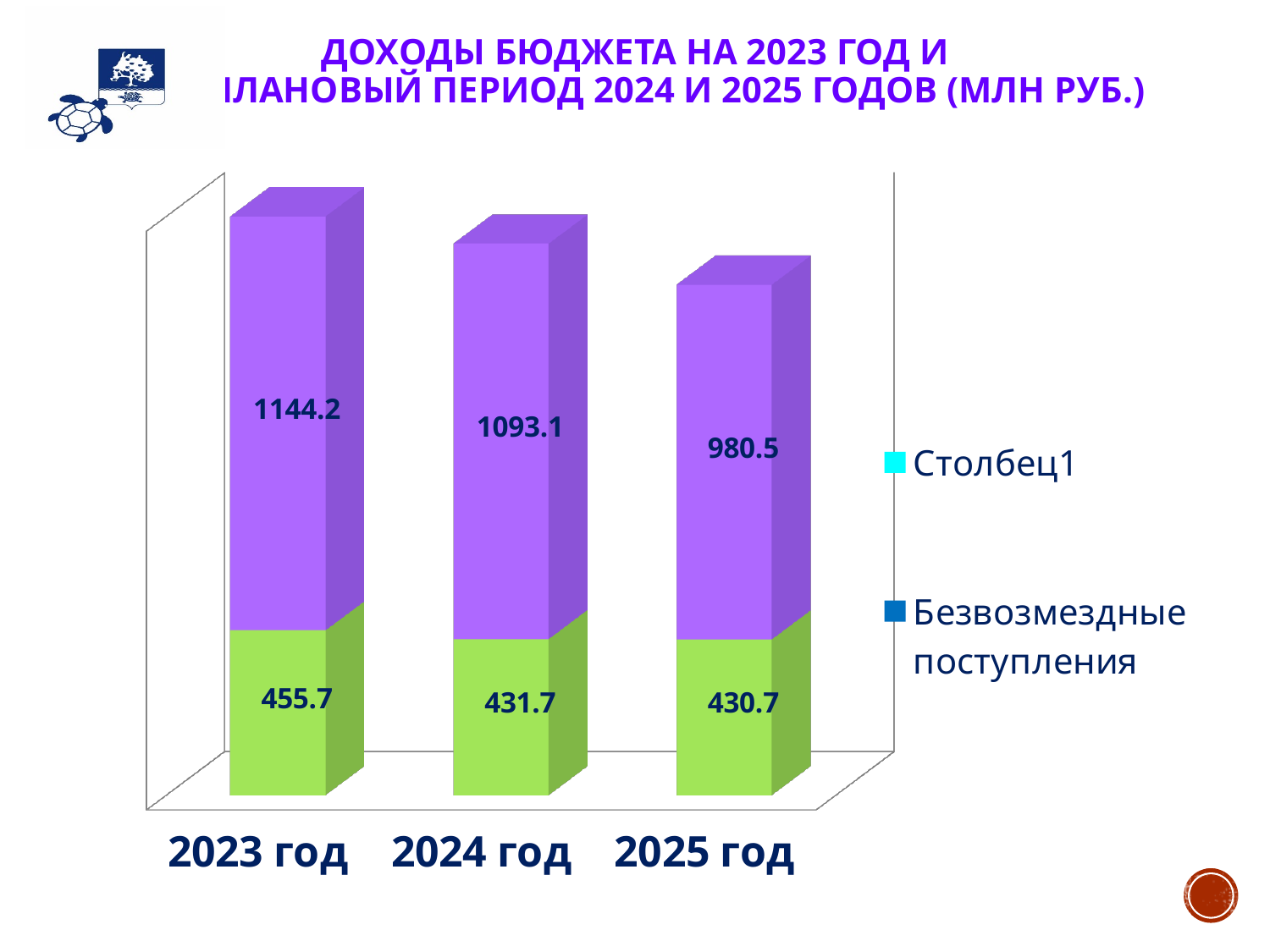
What is the difference between the purple (upper) segment values for 2024 год and 2025 год? 112.6 What is the value of the green (lower) segment for 2024 год? 431.7 How many categories (years) are shown on the x axis of the chart? 3 What is the total of the stacked bar for 2023 год? 1599.9 What is the value of the purple (upper) segment for 2023 год? 1144.2 Which year has the highest value for the purple (upper) segment? 2023 год What type of chart is shown on the slide? Stacked bar chart What is the value of the purple (upper) segment for 2025 год? 980.5 What is the value of the green (lower) segment for 2025 год? 430.7 How many series does the chart legend list? 2 Do the purple (upper) segment values rise or fall from 2023 год to 2025 год? Fall Which year has the lowest value for the purple (upper) segment? 2025 год